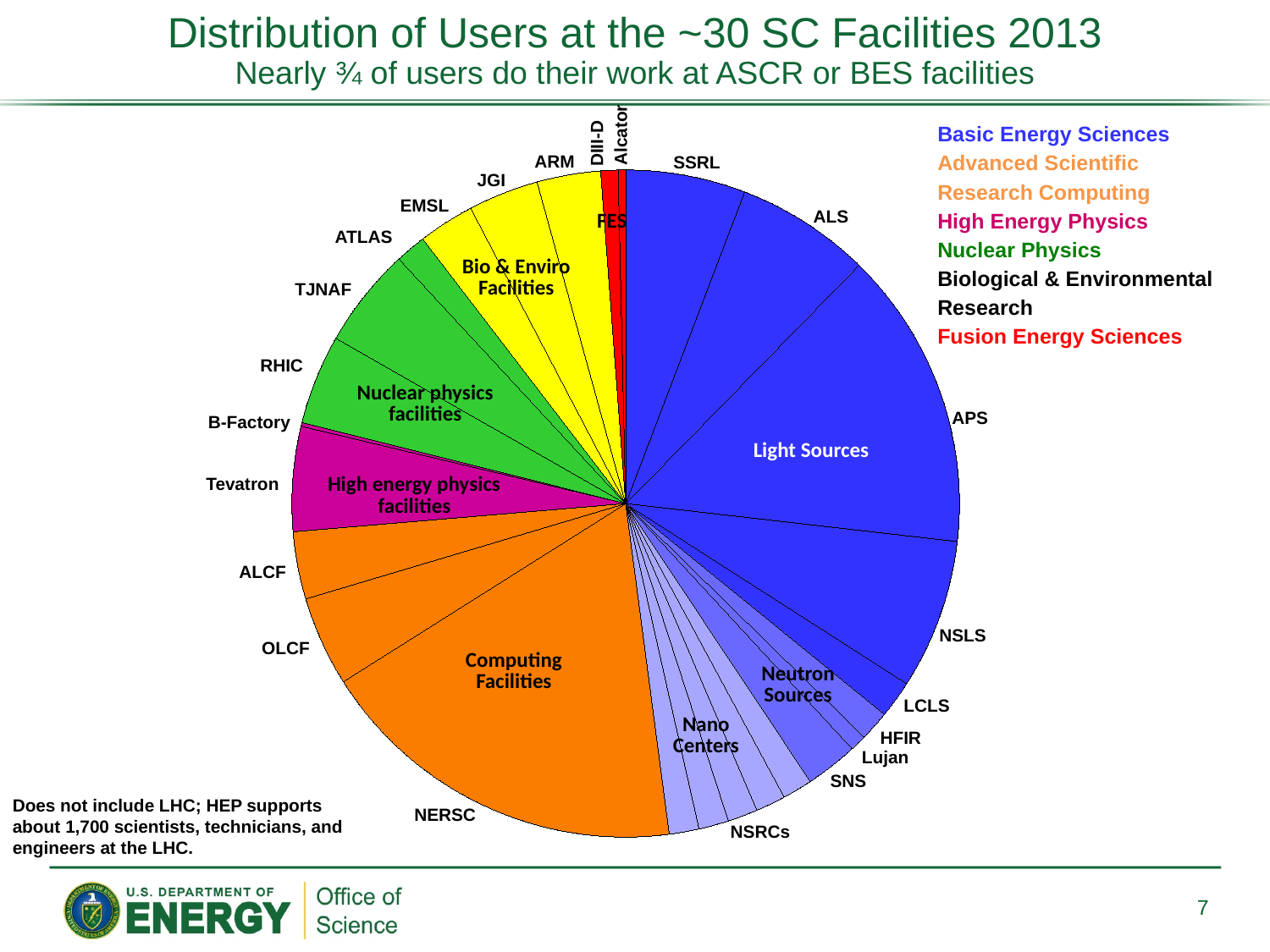
What is the title of the chart on the slide? Distribution of Users at the ~30 SC Facilities 2013 What kind of chart is shown on the slide? Pie chart Which slice is larger, ALCF or Alcator? ALCF How many program offices are listed in the chart's legend? 6 Which slice is larger, Tevatron or B-Factory? Tevatron Which slice is larger, SSRL or LCLS? SSRL Which facility has the smallest slice in the pie chart? Alcator Which facility has the largest slice in the pie chart? NERSC Which program office do the blue slices (Light Sources, Neutron Sources, Nano Centers) belong to, according to the legend? Basic Energy Sciences